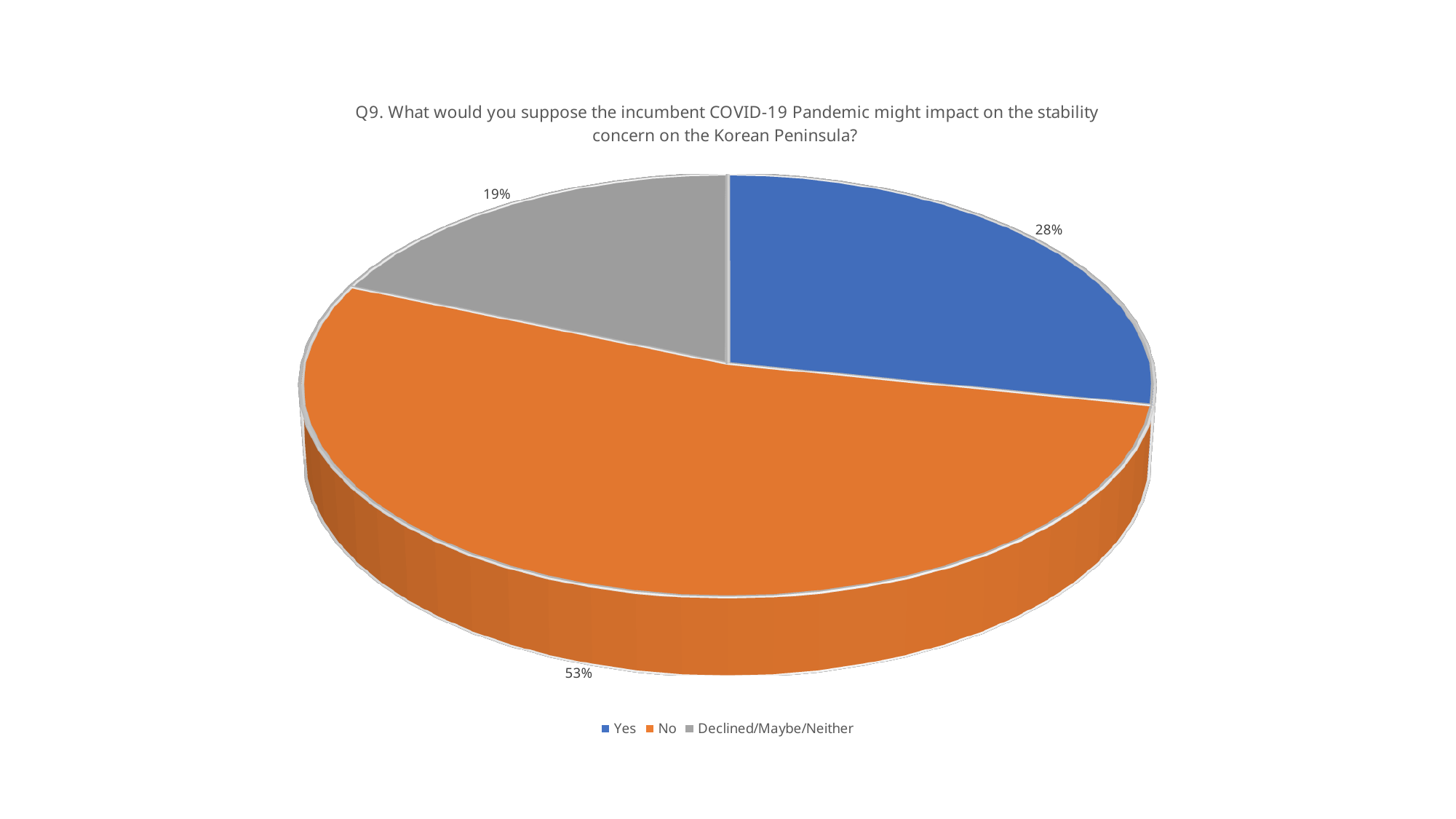
What percentage of respondents answered "No"? 53% How many entries does the legend list? 3 How many slices does the pie chart have? 3 Which response has the smallest share of the pie? Declined/Maybe/Neither What is the difference in percentage points between the "Yes" and "Declined/Maybe/Neither" shares? 9 What type of chart is shown on the slide? Pie chart What colour is the slice representing "No"? Orange What percentage of respondents answered "Declined/Maybe/Neither"? 19% Which response has the largest share of the pie? No What percentage of respondents answered "Yes"? 28% Which is larger, the share for "Yes" or the share for "Declined/Maybe/Neither"? Yes What is the difference in percentage points between the "No" and "Yes" shares? 25